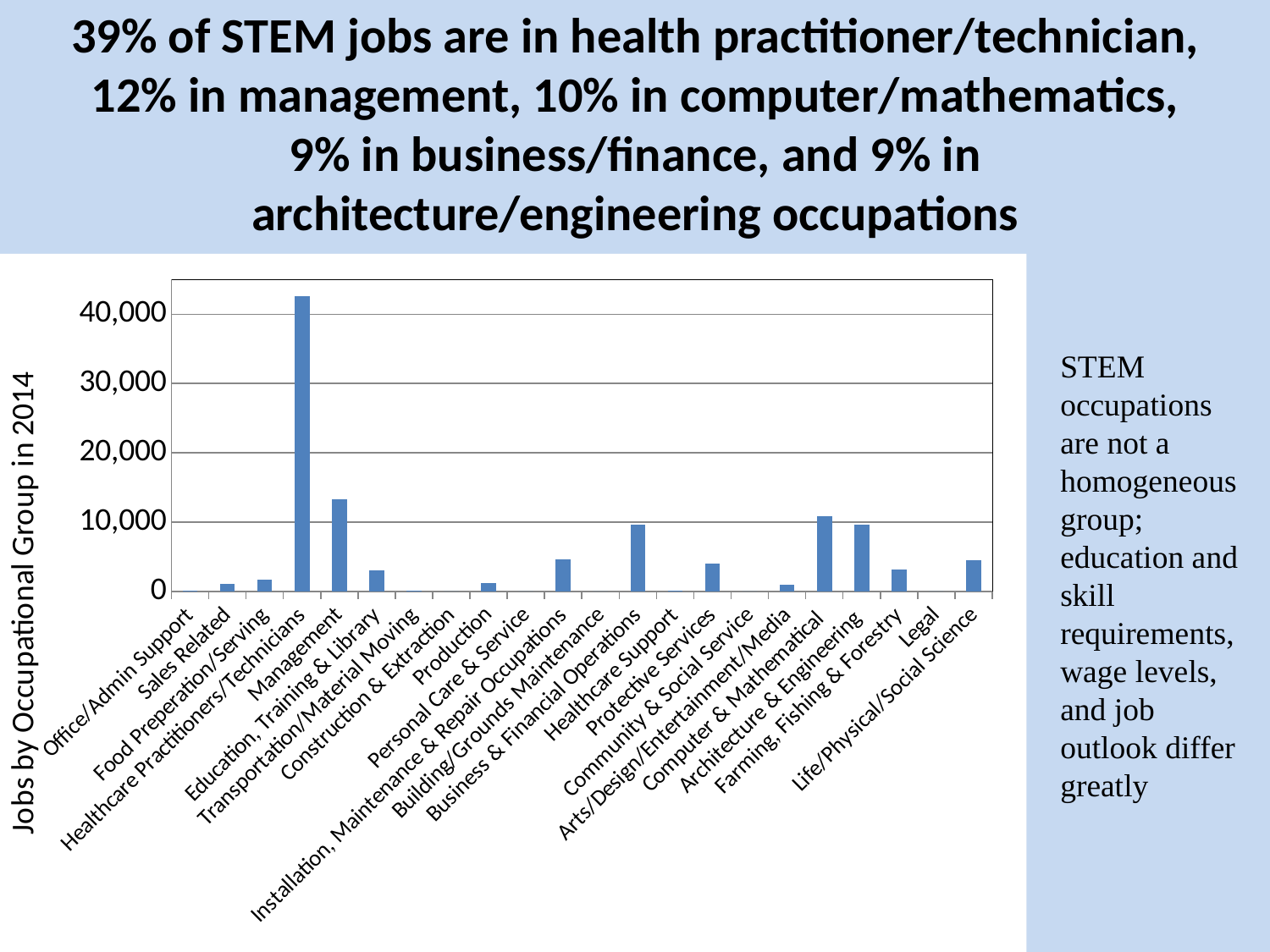
Which has more jobs, Management or Education, Training & Library? Management Is the value for Protective Services greater or less than 10,000? less Is the value for Management greater or less than 10,000? greater What kind of chart is shown on the slide? bar chart Is the value for Education, Training & Library greater or less than 10,000? less What is the label on the vertical axis of the chart? Jobs by Occupational Group in 2014 Which has more jobs, Healthcare Practitioners/Technicians or Management? Healthcare Practitioners/Technicians How many occupational groups are shown on the x axis of the chart? 22 Which has more jobs, Computer & Mathematical or Protective Services? Computer & Mathematical Which occupational group has the highest number of jobs in the chart? Healthcare Practitioners/Technicians